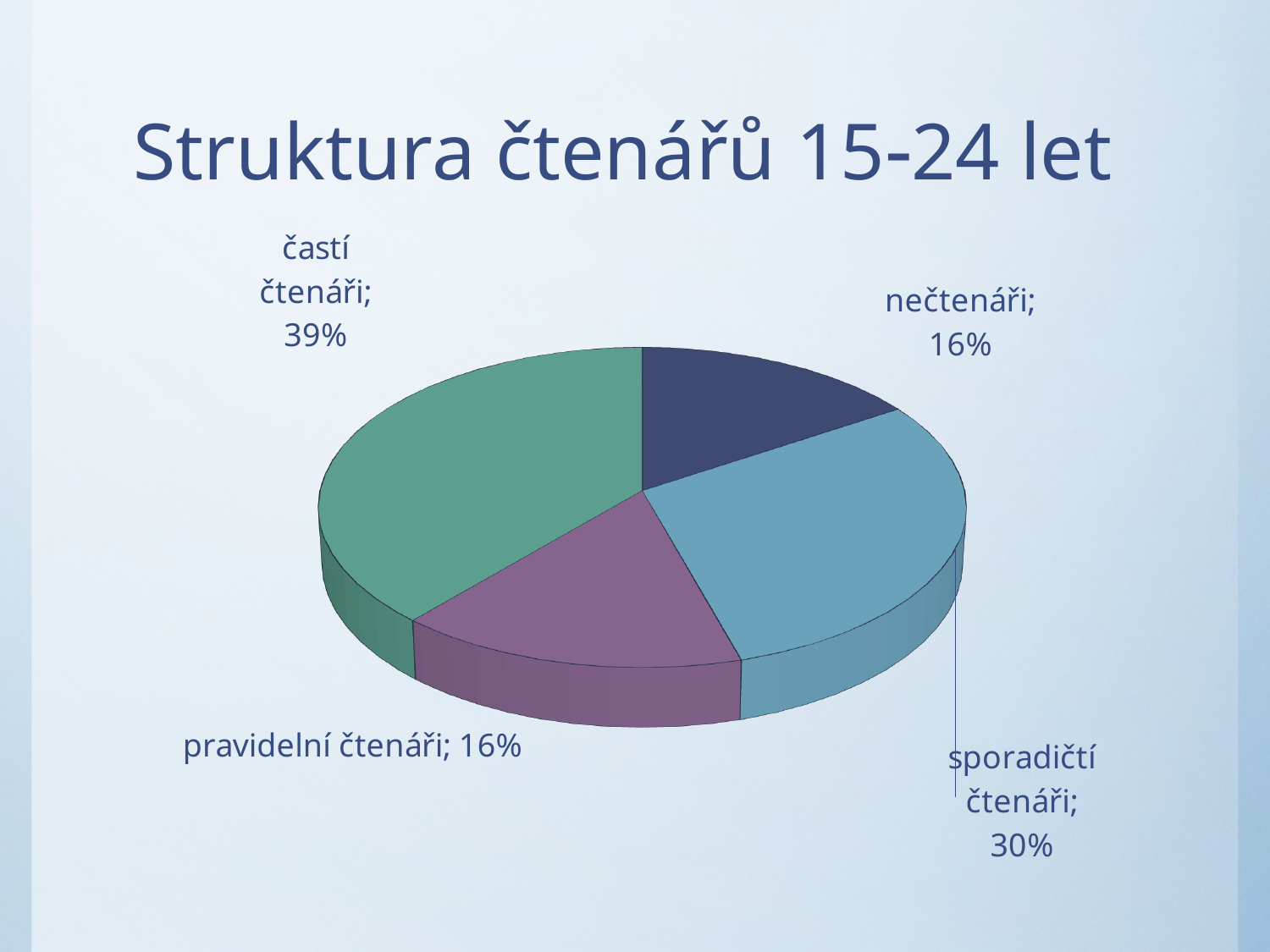
What is the share of 'nečtenáři'? 16% What is the share of 'častí čtenáři' in the pie chart? 39% What is the combined share of 'nečtenáři' and 'pravidelní čtenáři'? 32% How many categories (slices) does the pie chart have? 4 What is the difference in percentage points between 'častí čtenáři' and 'sporadičtí čtenáři'? 9 What is the title of the chart on the slide? Struktura čtenářů 15-24 let What kind of chart is shown on the slide? pie chart Which category has the largest share of the pie? častí čtenáři What colour is the slice for 'častí čtenáři'? green Which is larger: the share of 'sporadičtí čtenáři' or the share of 'nečtenáři'? sporadičtí čtenáři What is the share of 'sporadičtí čtenáři'? 30% What is the share of 'pravidelní čtenáři'? 16%